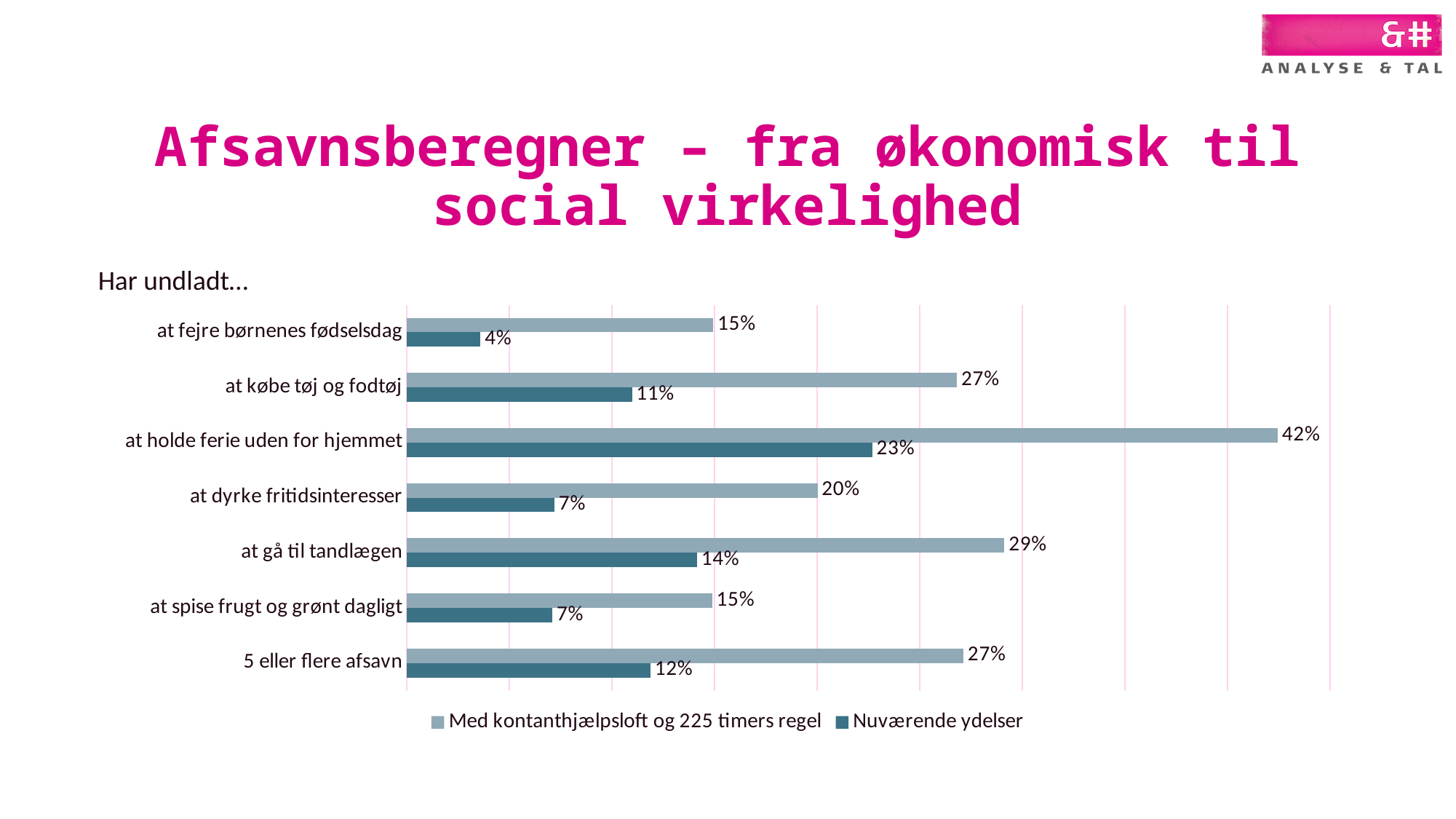
How many series does the legend list? 2 Which is larger: the 'Nuværende ydelser' value for 'at gå til tandlægen' or for '5 eller flere afsavn'? at gå til tandlægen How many categories are shown on the chart? 7 What is the value for 'at gå til tandlægen' in the 'Nuværende ydelser' series? 14% Which category has the highest value in the 'Med kontanthjælpsloft og 225 timers regel' series? at holde ferie uden for hjemmet What is the value for 'at holde ferie uden for hjemmet' in the 'Med kontanthjælpsloft og 225 timers regel' series? 42% What is the text shown above the chart? Har undladt… What is the value for 'at fejre børnenes fødselsdag' in the 'Nuværende ydelser' series? 4% What kind of chart is shown on the slide? bar chart Which category has the lowest value in the 'Nuværende ydelser' series? at fejre børnenes fødselsdag What is the difference between the two series for 'at holde ferie uden for hjemmet'? 19% What is the difference between the two series for 'at købe tøj og fodtøj'? 16%